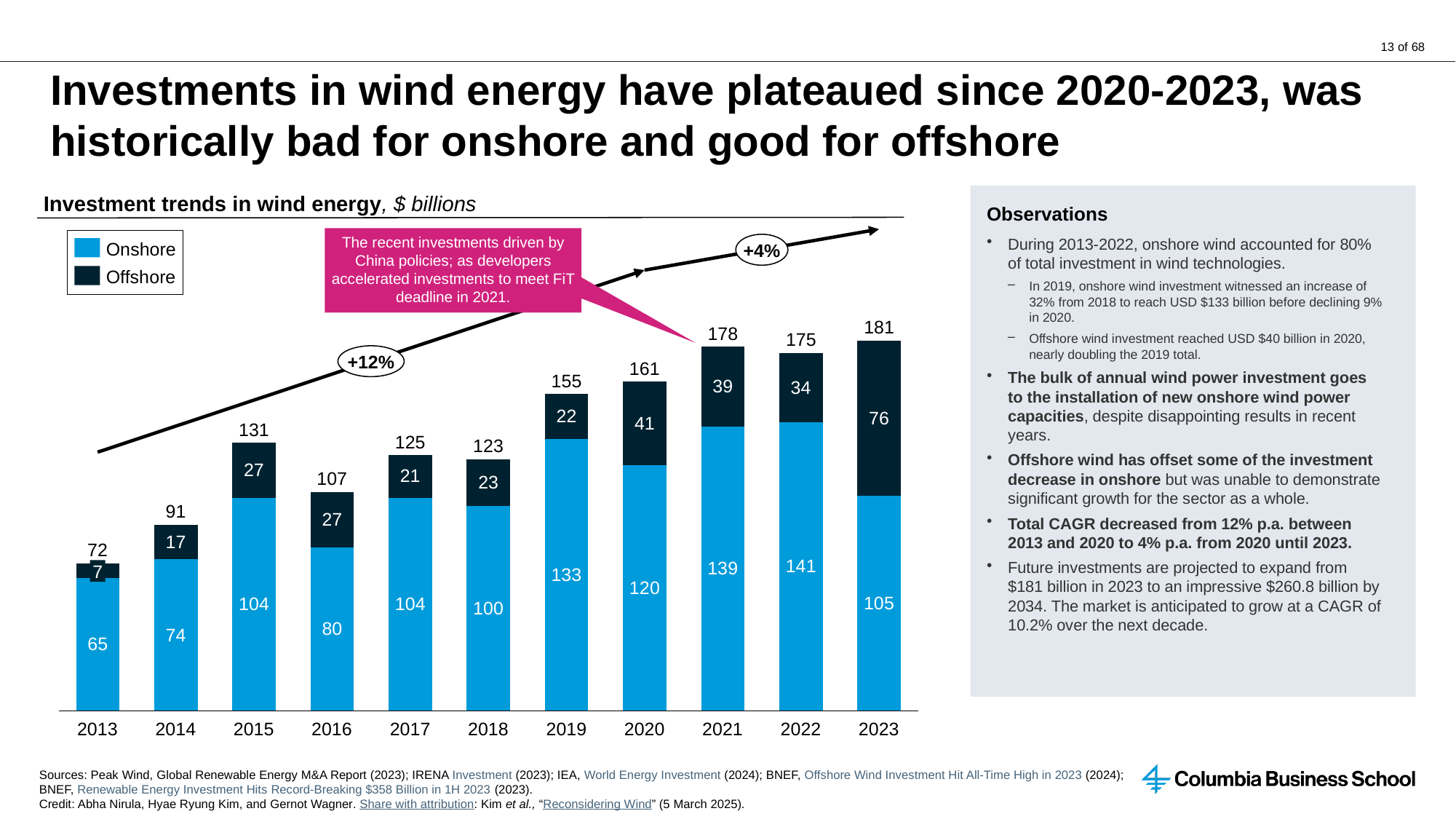
What kind of chart is used to show investment trends in wind energy? Stacked bar chart What is the offshore wind investment value for 2023? 76 How many series does the chart legend list? 2 How many years are shown on the x axis of the chart? 11 Which year has the lowest offshore wind investment? 2013 Which is larger, the onshore investment in 2022 or in 2023? 2022 What is the total wind energy investment shown for 2021? 178 What is the difference between the total investment in 2023 and in 2013? 109 What unit is given in the chart title for the investment values? $ billions What is the sum of the onshore and offshore values for 2020? 161 What is the onshore wind investment value for 2019? 133 Which year has the highest total wind energy investment? 2023